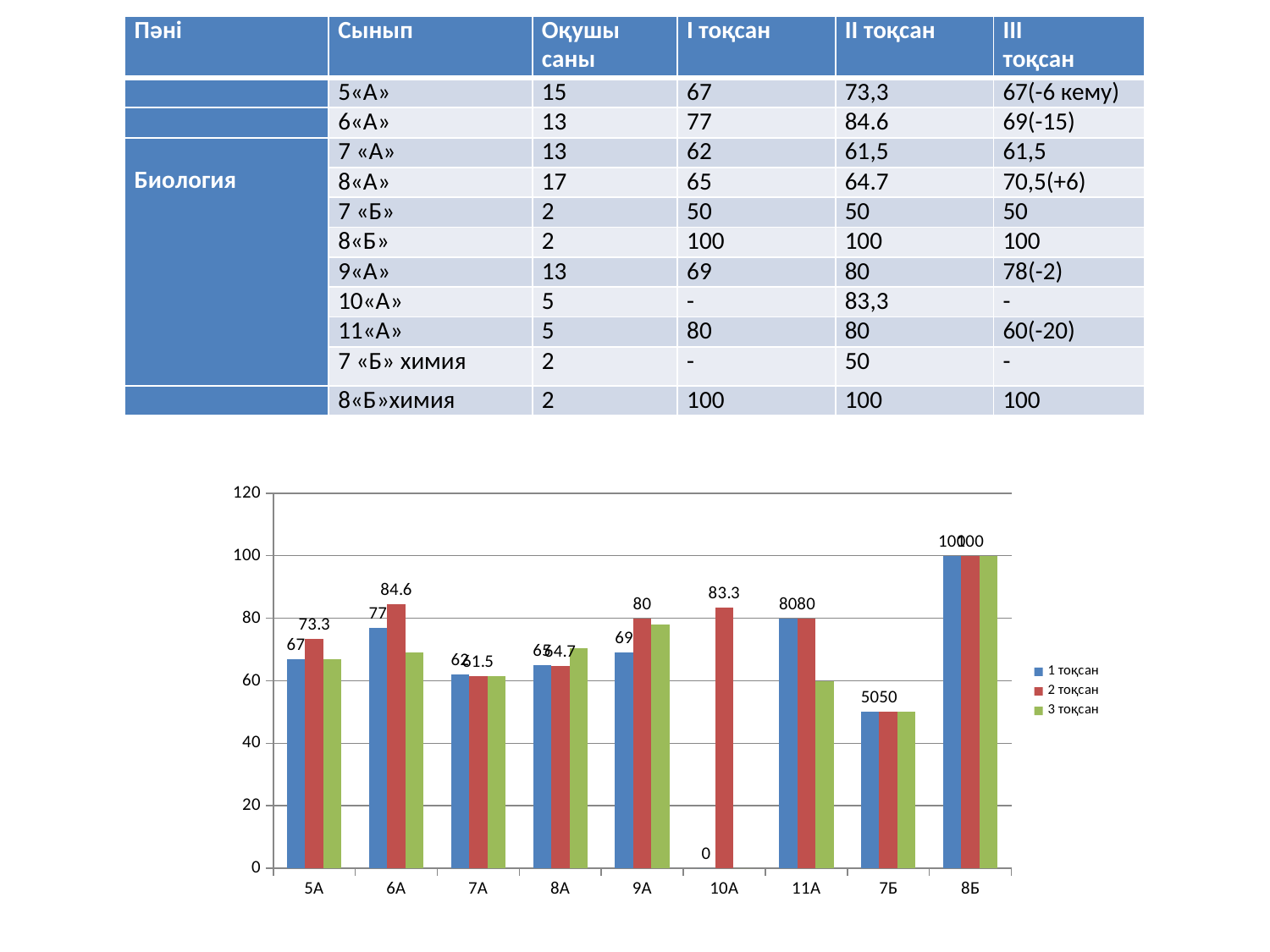
How many categories are shown on the x axis of the chart? 9 What is the 1 тоқсан value for 10A in the chart? 0 Which category has the highest 2 тоқсан value in the chart? 8Б Which category has the lowest 1 тоқсан value in the chart? 10A In the chart, what is the difference between the 2 тоқсан and 1 тоқсан values for 9A? 11 What is the 2 тоқсан value for 10A in the chart? 83.3 For 5A in the chart, which is larger: the 1 тоқсан value or the 2 тоқсан value? 2 тоқсан Is the 3 тоқсан value for 11A in the chart greater or less than 80? less What is the 1 тоқсан value for 9A in the chart? 69 How many series does the chart legend list? 3 What is the 2 тоқсан value for 6A in the chart? 84.6 What kind of chart is shown on the slide? bar chart